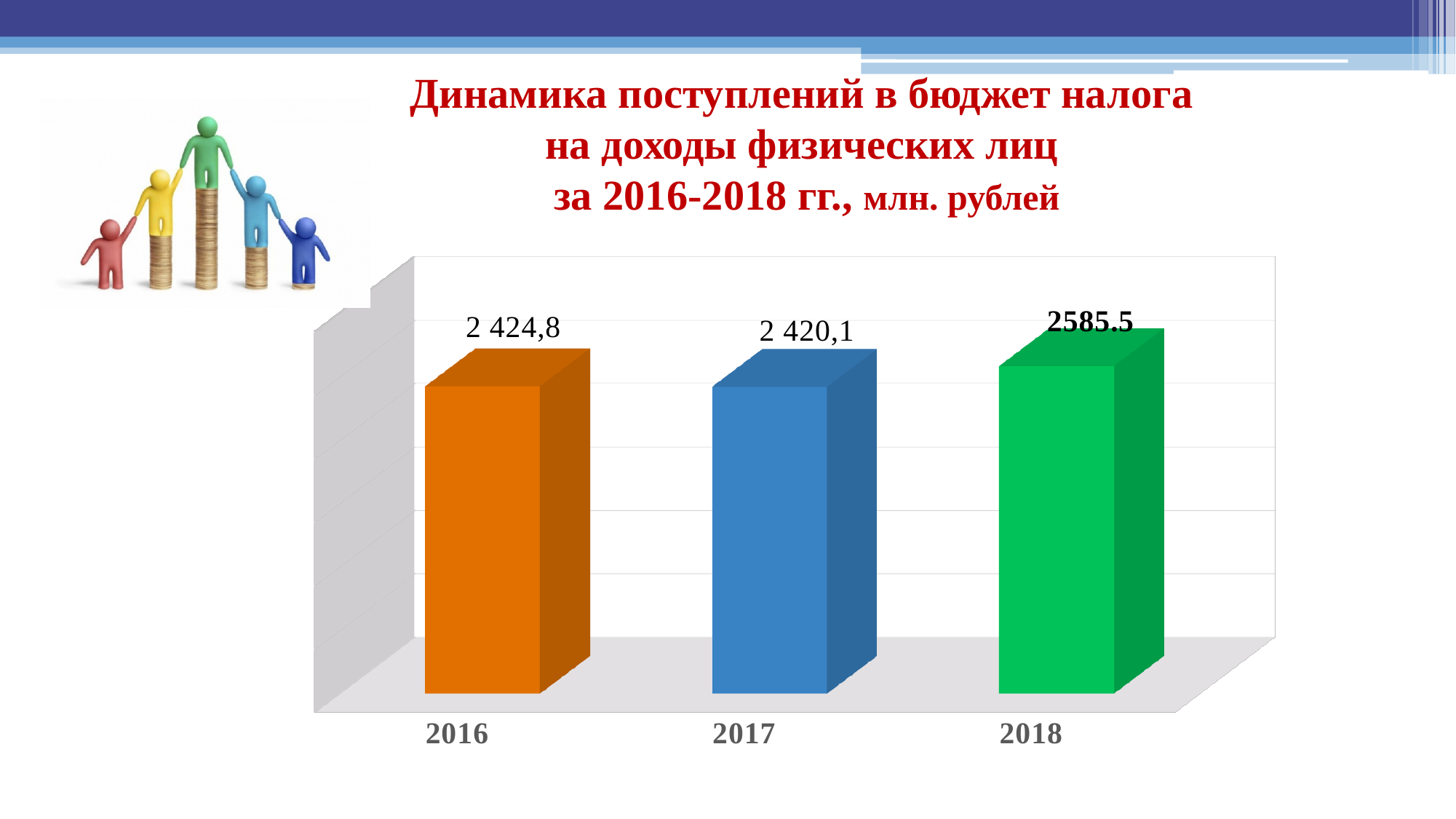
Which year has the highest value? 2018 What kind of chart is shown on the slide? Bar chart Which is larger, the value for 2016 or the value for 2017? 2016 What colour is the bar for 2018? Green Does the value rise or fall from 2017 to 2018? Rise What is the difference between the values for 2016 and 2017? 4,7 What is the value for 2016? 2 424,8 How many years are shown on the chart? 3 What is the value for 2017? 2 420,1 In what units are the values on the chart given, according to the title? млн. рублей What is the value for 2018? 2585.5 Which year has the lowest value? 2017